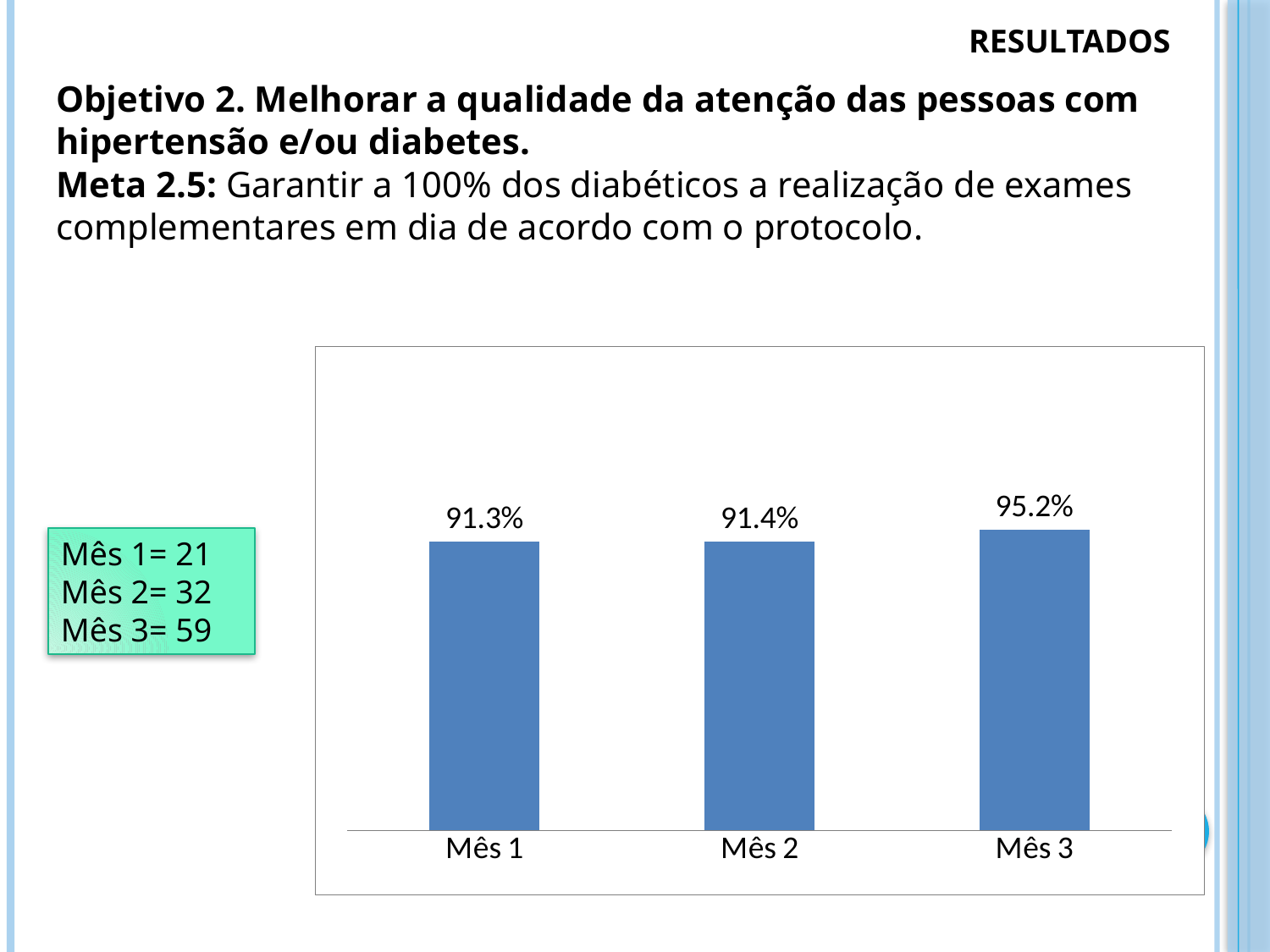
What is the value for Mês 2? 91.4% What kind of chart is shown on the slide? Bar chart What colour are the bars in the chart? Blue Which is larger, the value for Mês 3 or the value for Mês 1? Mês 3 What is the difference between the values for Mês 3 and Mês 2? 3.8% What is the difference between the values for Mês 3 and Mês 1? 3.9% Do the values rise or fall from Mês 1 to Mês 3? Rise How many categories are shown on the x axis of the chart? 3 Which month has the highest value? Mês 3 According to the text box beside the chart, what is the number for Mês 3? 59 What is the value for Mês 3? 95.2% What is the value for Mês 1? 91.3%